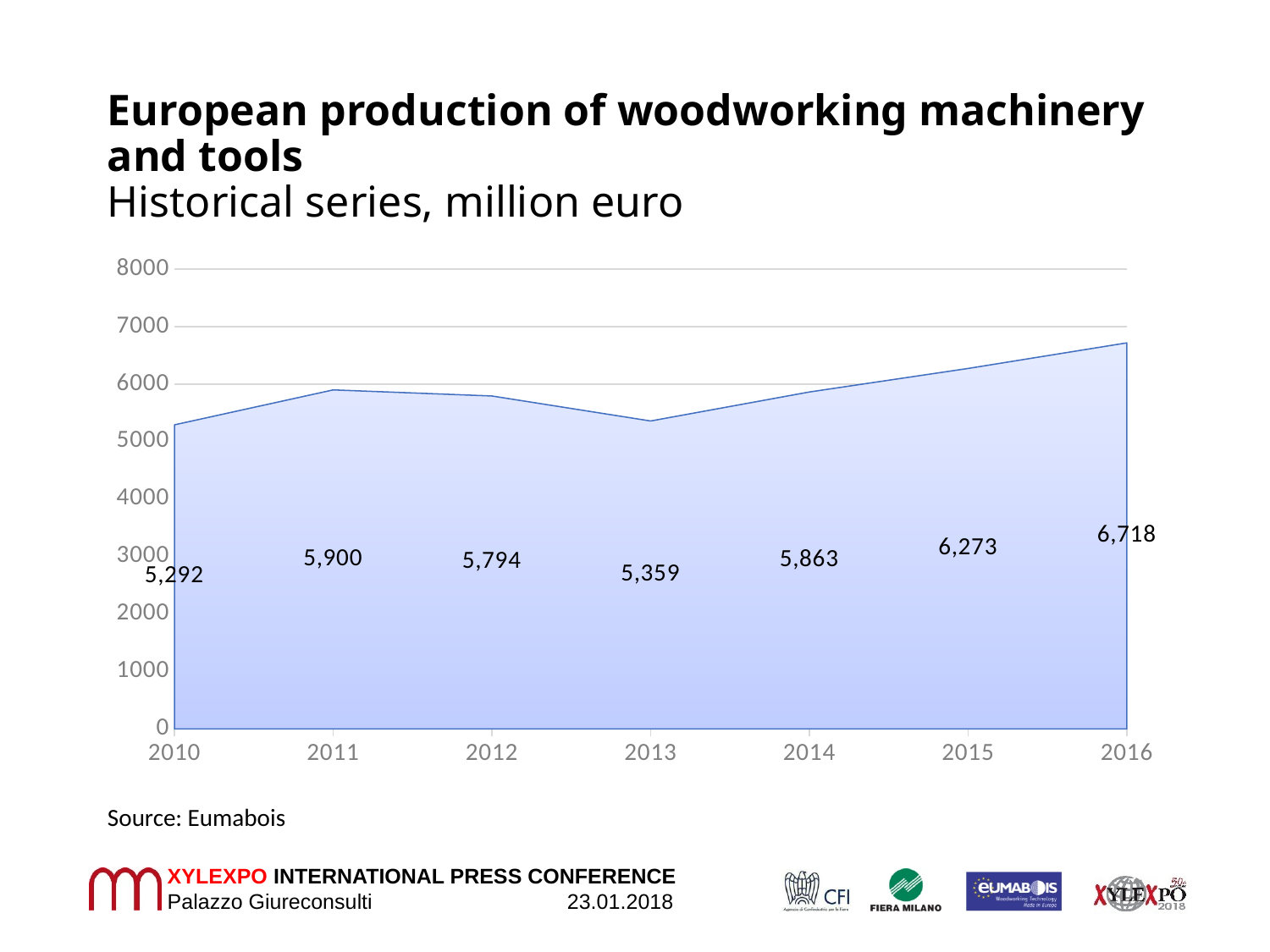
What value is shown for 2013? 5,359 What is the difference between the 2016 and 2015 values? 445 How many years are plotted on the chart? 7 Do the values rise or fall from 2013 to 2016? rise What was the European production of woodworking machinery and tools in 2010? 5,292 Which year has the highest value? 2016 What kind of chart is shown on the slide? area chart Which is larger, the value for 2011 or the value for 2014? 2011 Is the value for 2015 greater or less than 6000? greater Which year has the lowest value? 2010 What value is shown for 2016? 6,718 What is the source cited for the chart? Eumabois